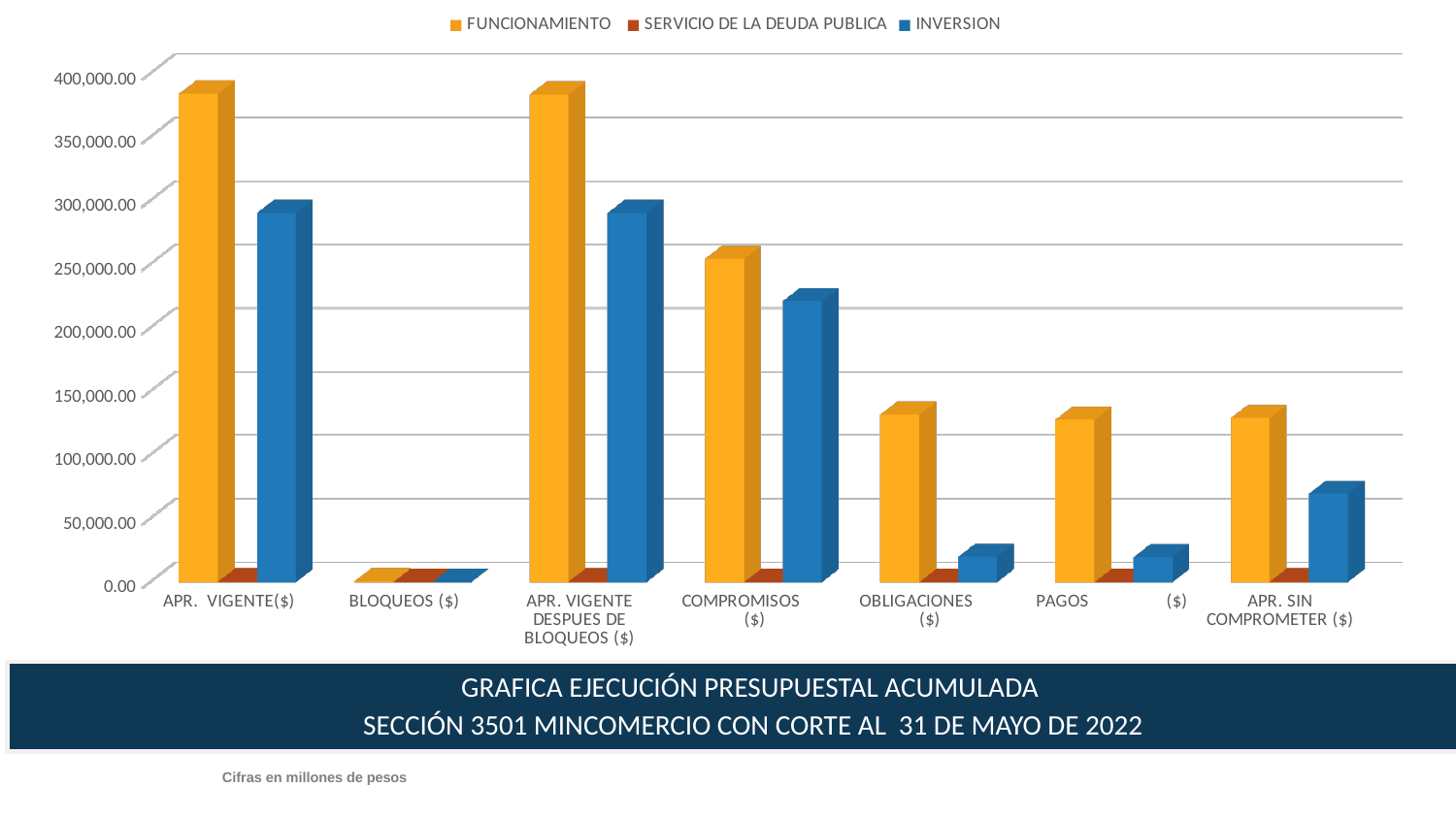
For COMPROMISOS ($), which series has the larger value, FUNCIONAMIENTO or INVERSION? FUNCIONAMIENTO How many series does the legend list? 3 Which category has the lowest FUNCIONAMIENTO value? BLOQUEOS ($) Is the FUNCIONAMIENTO value for COMPROMISOS ($) greater or less than 200,000.00? greater Which series is shown in blue in the legend? INVERSION Is the INVERSION value for OBLIGACIONES ($) greater or less than 50,000.00? less Is the FUNCIONAMIENTO value for APR. VIGENTE($) greater or less than 350,000.00? greater What kind of chart is shown on the slide? Bar chart Which series has the smallest values across all categories? SERVICIO DE LA DEUDA PUBLICA How many categories are shown along the x axis? 7